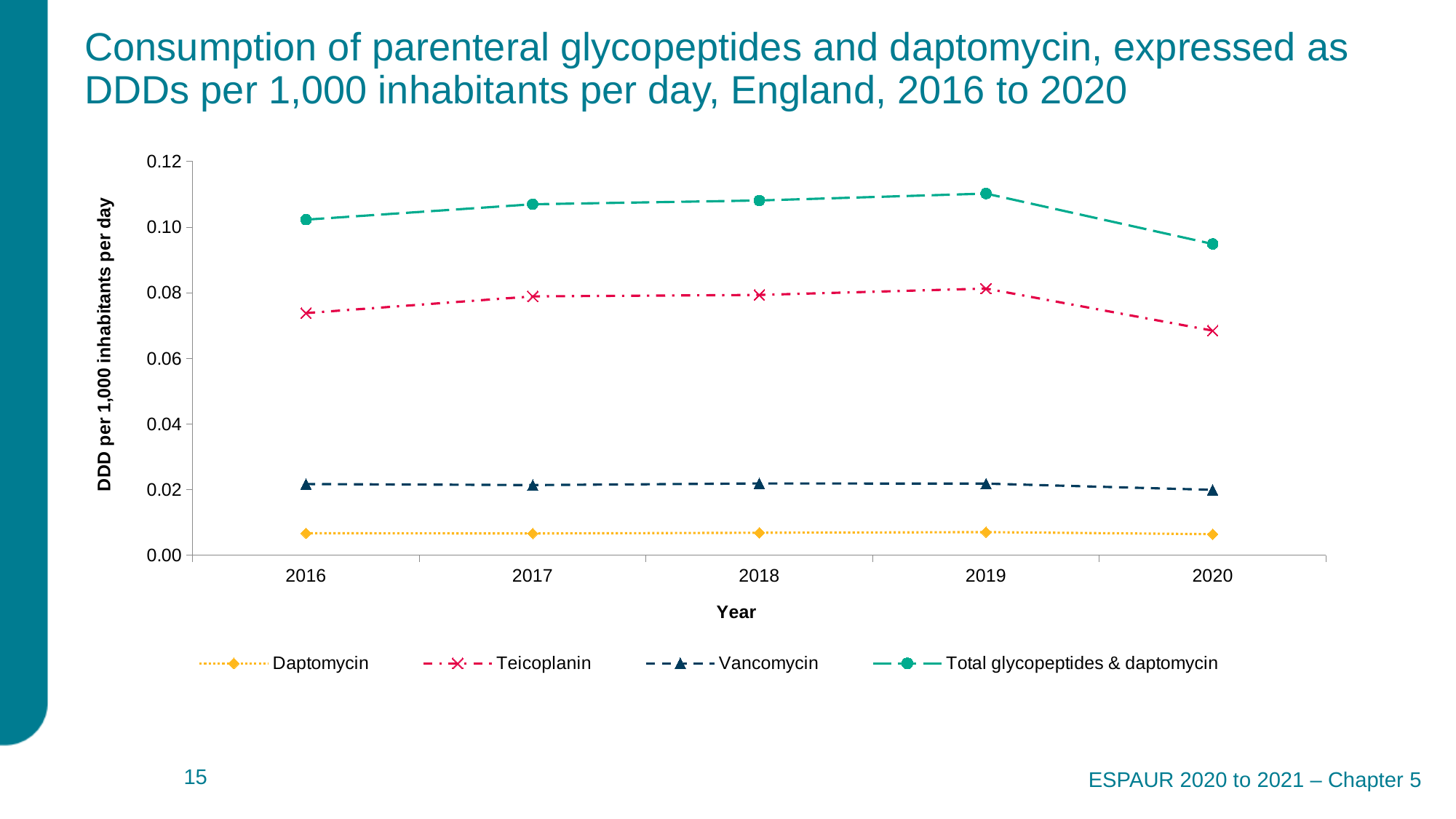
How many series does the legend list? 4 Does the value for Total glycopeptides & daptomycin rise or fall from 2019 to 2020? fall In which year is the value for Teicoplanin lowest? 2020 What kind of chart is shown on the slide? line chart Which series has the lowest values across all years? Daptomycin Is the value for Teicoplanin in 2016 greater or less than 0.08? less Is the value for Vancomycin in 2018 greater or less than 0.04? less How many years are plotted along the x axis? 5 In 2018, which is larger: the value for Teicoplanin or the value for Vancomycin? Teicoplanin In which year is the value for Total glycopeptides & daptomycin lowest? 2020 Is the value for Total glycopeptides & daptomycin in 2020 greater or less than 0.10? less